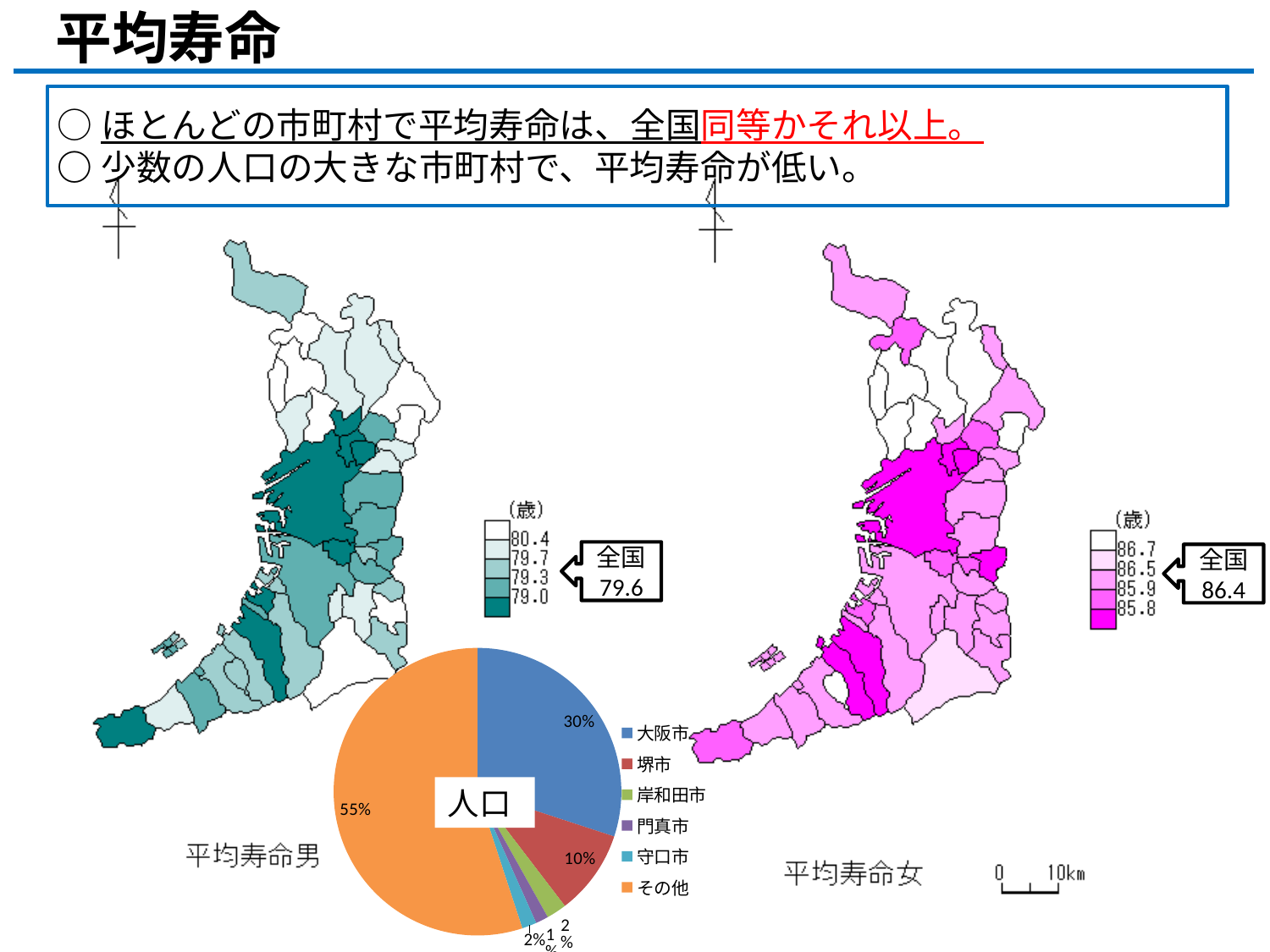
In the 人口 pie chart, what share does 門真市 have? 1% What kind of chart is the 人口 chart at the bottom of the slide? pie chart In the 人口 pie chart, what share does 堺市 have? 10% In the 人口 pie chart, which is larger, the share of 大阪市 or the share of その他? その他 In the 人口 pie chart, which category has the smallest slice? 門真市 In the 人口 pie chart, what is the difference between the shares of 大阪市 and 堺市? 20% In the 人口 pie chart, which category has the largest slice? その他 In the 人口 pie chart, what colour is the 大阪市 slice? blue On the 平均寿命男 map, what is the 全国 (national) value shown in the callout? 79.6 How many categories does the legend of the 人口 pie chart list? 6 In the 人口 pie chart, what share does 大阪市 have? 30% In the 人口 pie chart, what share does その他 have? 55%